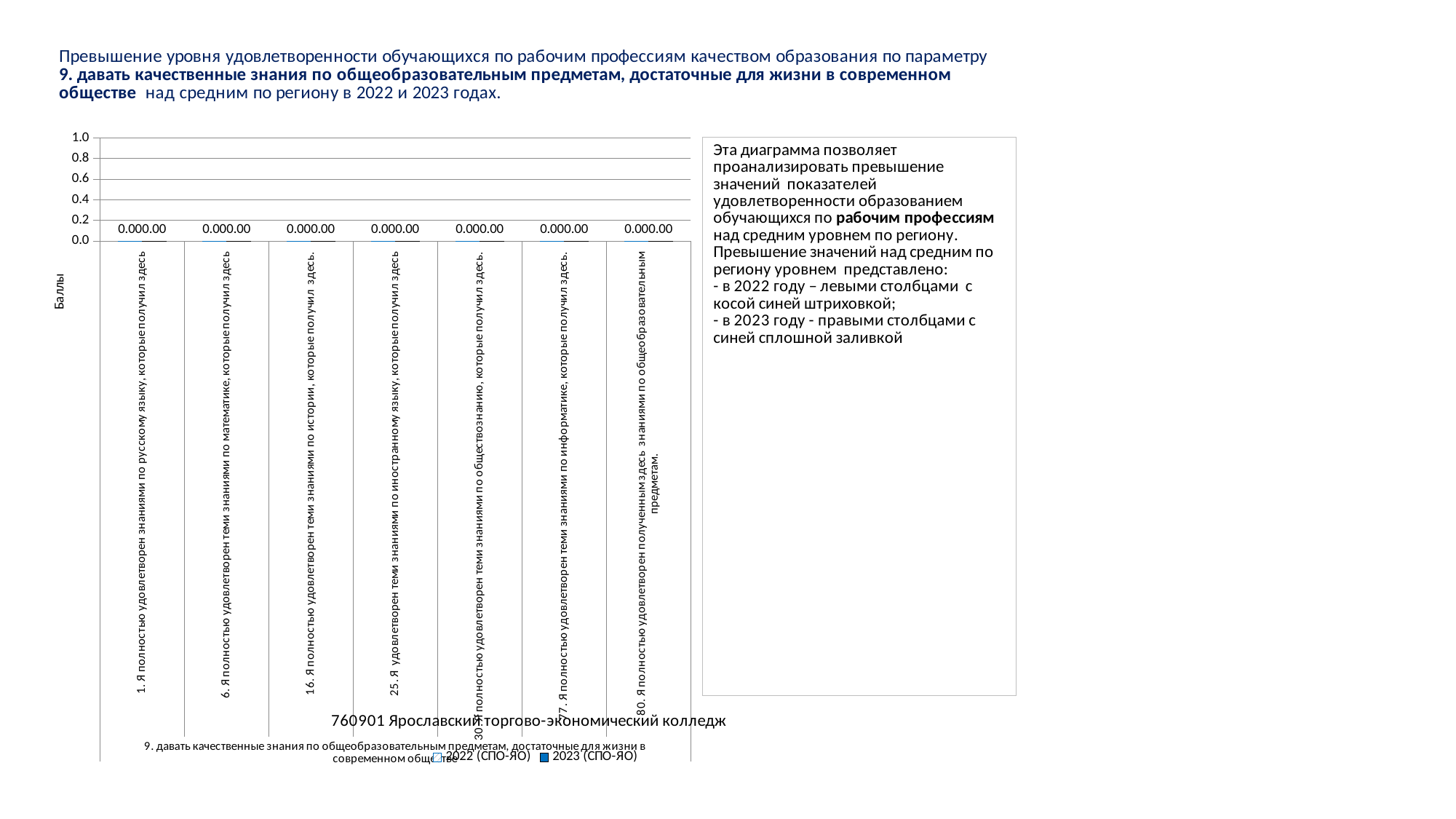
Is the value for category "6. Я полностью удовлетворен теми знаниями по математике, которые получил здесь" greater or less than 0.4? less How many categories are shown along the x axis of the chart? 7 What kind of chart is shown on the slide? bar chart What is the highest tick value shown on the vertical axis of the chart? 1.0 Is the value for category "16. Я полностью удовлетворен теми знаниями по истории, которые получил здесь" greater or less than 0.6? less How many series does the chart legend list? 2 Is the value for category "80. Я полностью удовлетворен полученным здесь знаниями по общеобразовательным предметам." greater or less than 0.2? less What are the two series named in the chart legend? 2022 (СПО-ЯО) and 2023 (СПО-ЯО) What is the label of the vertical axis of the chart? Баллы